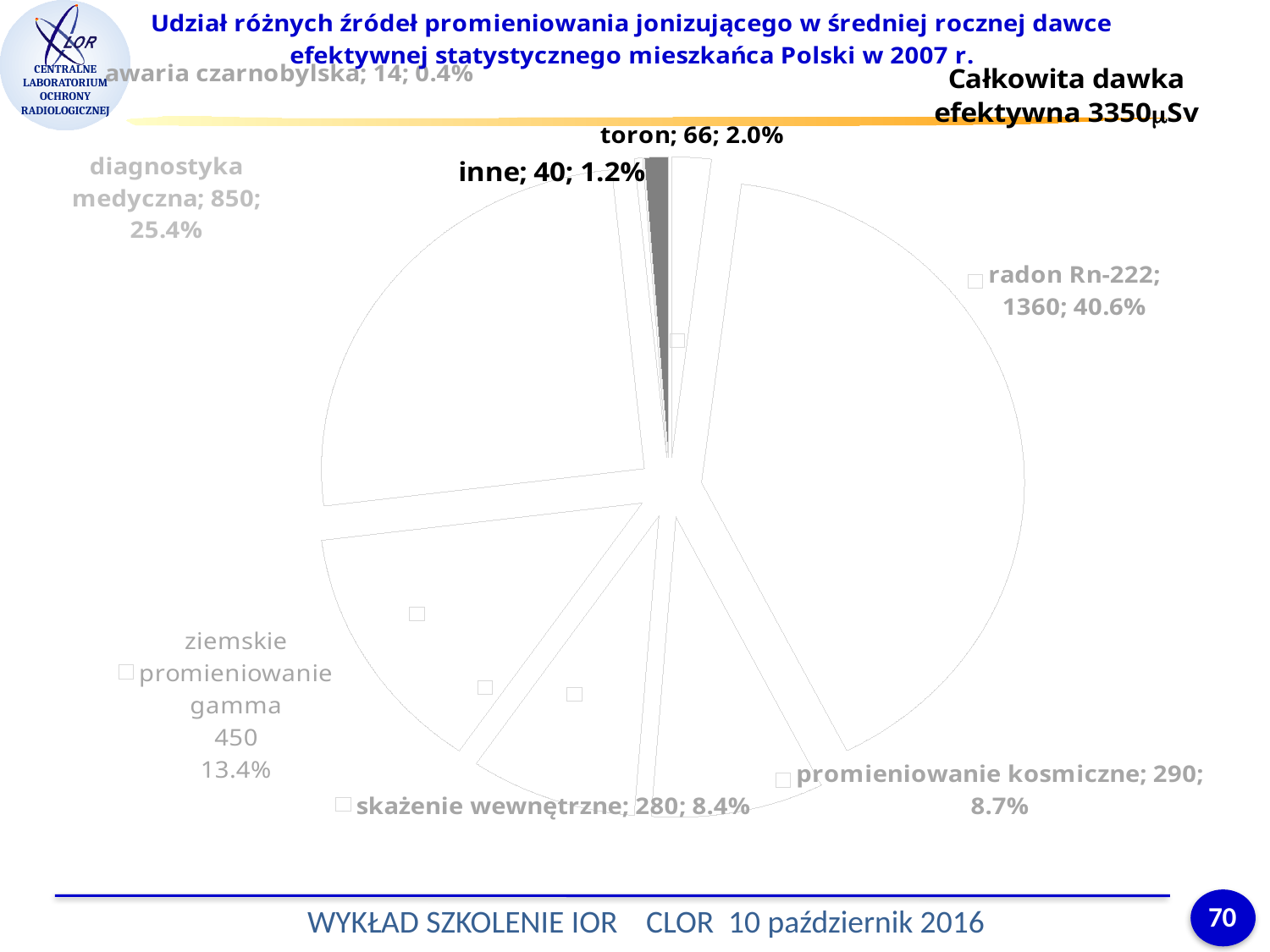
What total effective dose (Całkowita dawka efektywna) is stated on the slide? 3350 μSv What is the difference between the values for radon Rn-222 and diagnostyka medyczna? 510 Which source has the smallest share of the pie? awaria czarnobylska What value is shown for radon Rn-222? 1360 What percentage share is shown for diagnostyka medyczna? 25.4% How many slices does the pie chart have? 8 What is the difference between the values for promieniowanie kosmiczne and skażenie wewnętrzne? 10 What value is shown for toron? 66 What kind of chart is shown on the slide? pie chart Which source has the largest share of the pie? radon Rn-222 What percentage share is shown for awaria czarnobylska? 0.4% Which is larger, the value for ziemskie promieniowanie gamma or the value for skażenie wewnętrzne? ziemskie promieniowanie gamma